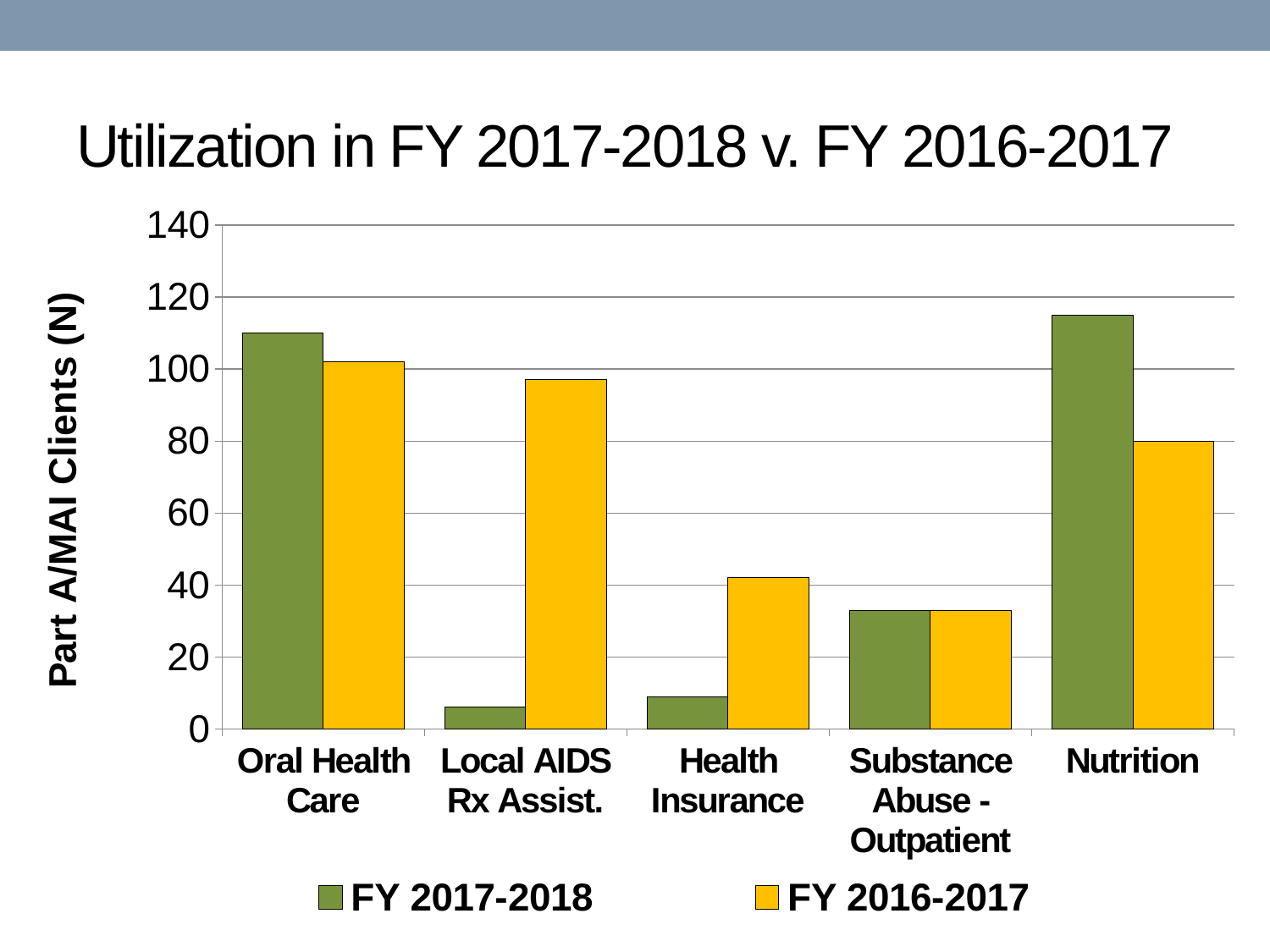
Which category has the lowest FY 2016-2017 value? Substance Abuse - Outpatient Which category has the highest FY 2016-2017 value? Oral Health Care How many series does the legend list? 2 Which category has the highest FY 2017-2018 value? Nutrition Which category has the lowest FY 2017-2018 value? Local AIDS Rx Assist. Is the FY 2017-2018 value for Oral Health Care greater or less than 100? greater What is the label on the y axis? Part A/MAI Clients (N) For Nutrition, which series has the larger value, FY 2017-2018 or FY 2016-2017? FY 2017-2018 How many categories are shown on the x axis? 5 For Health Insurance, which series has the larger value, FY 2017-2018 or FY 2016-2017? FY 2016-2017 What kind of chart is shown on the slide? bar chart